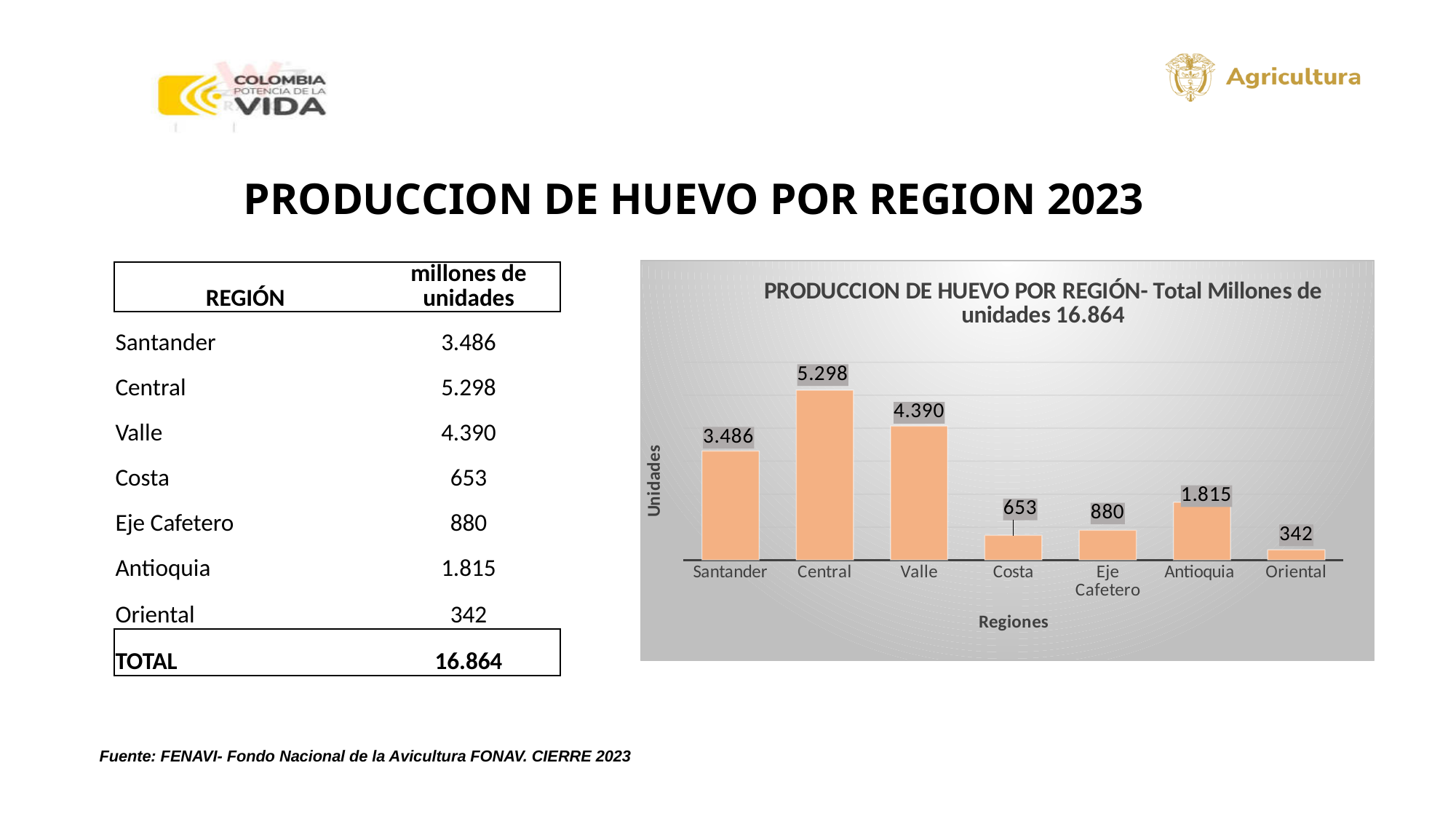
What is the difference between the values for Central and Valle? 908 How many regions are shown in the chart? 7 What is the value for Central in the chart? 5.298 What is the label of the x axis of the chart? Regiones Which region has the lowest value in the chart? Oriental Which region has the highest value in the chart? Central What kind of chart is shown on the slide? Bar chart What is the value for Eje Cafetero in the chart? 880 What is the difference between the values for Antioquia and Costa? 1.162 Which is larger, the value for Costa or the value for Eje Cafetero? Eje Cafetero What is the value for Oriental in the chart? 342 Which is larger, the value for Santander or the value for Valle? Valle